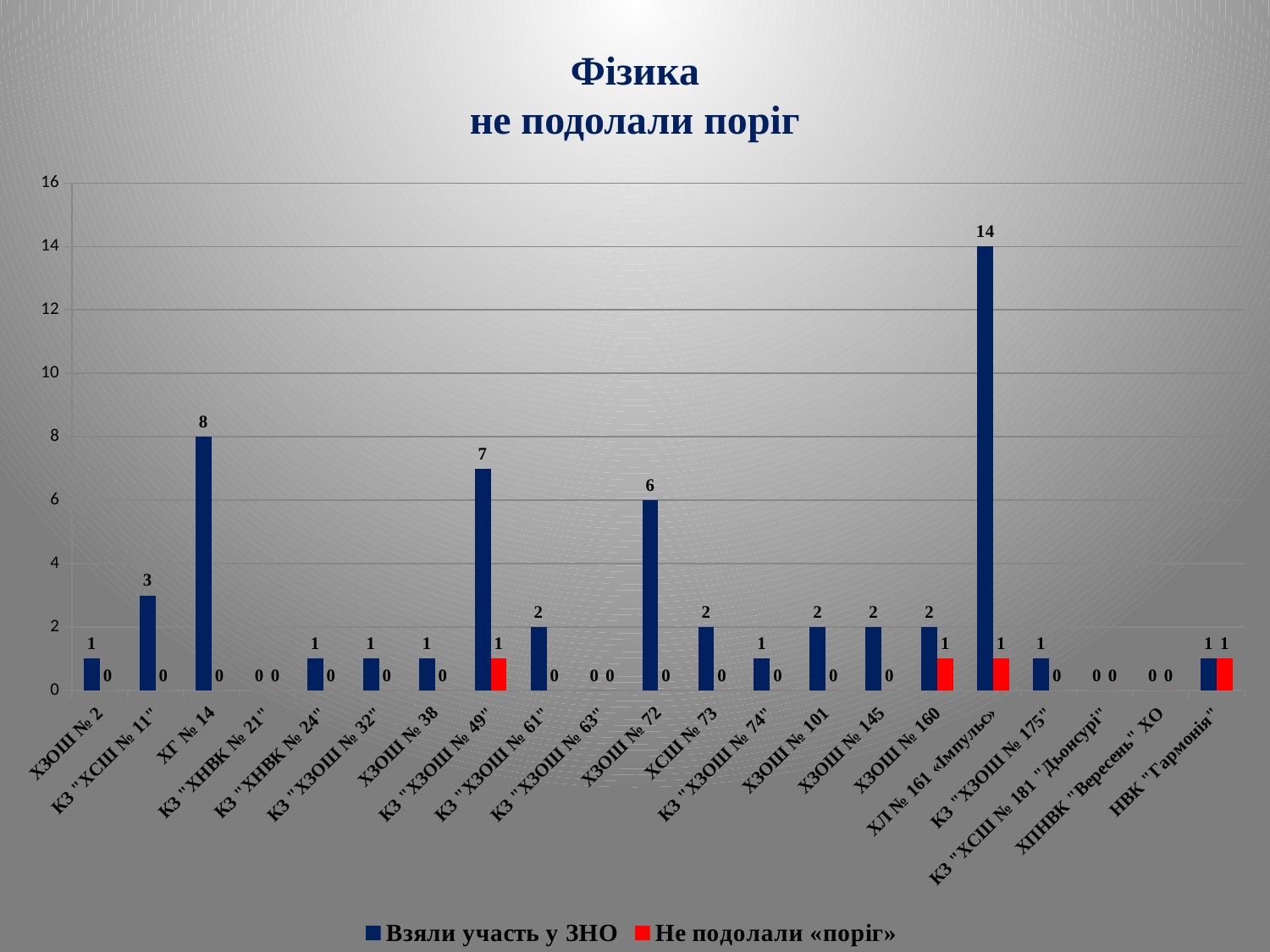
What is the value of Не подолали «поріг» for КЗ "ХЗОШ № 49"? 1 What is the value of Взяли участь у ЗНО for КЗ "ХСШ № 11"? 3 How many participants (Взяли участь у ЗНО) are shown for ХЛ № 161 «Імпульс»? 14 What kind of chart is shown on the slide? Bar chart What is the difference between the Взяли участь у ЗНО values for ХЛ № 161 «Імпульс» and ХГ № 14? 6 Which colour represents the series Не подолали «поріг» in the legend? Red Which school has the highest value for Взяли участь у ЗНО? ХЛ № 161 «Імпульс» Which has a larger Взяли участь у ЗНО value: КЗ "ХЗОШ № 49" or ХЗОШ № 72? КЗ "ХЗОШ № 49" How many schools (categories) are shown on the x axis? 21 What is the title of the chart? Фізика не подолали поріг How many series does the legend list? 2 What is the value of Взяли участь у ЗНО for ХГ № 14? 8